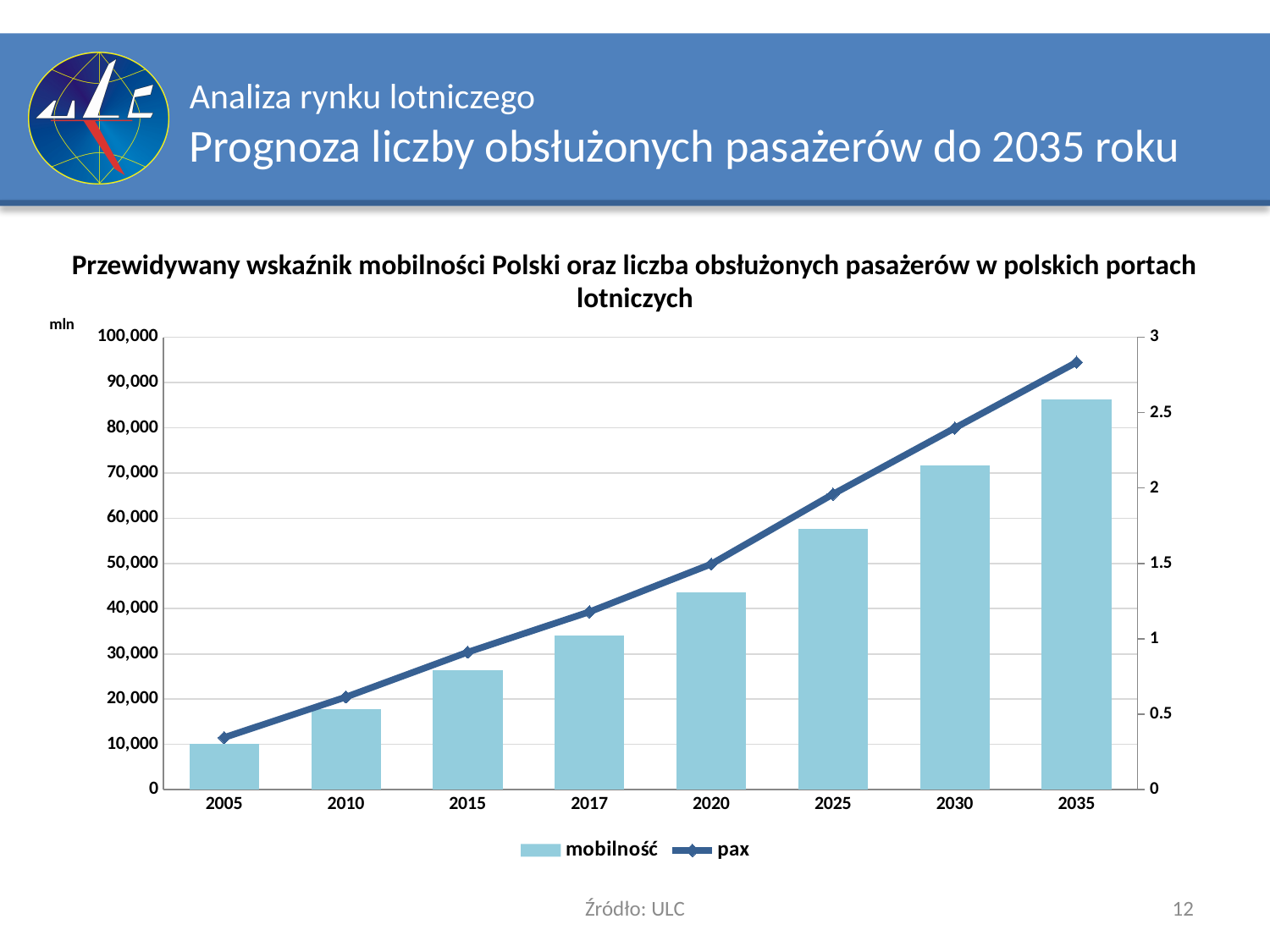
Which year has the tallest bar in the chart? 2035 Is the bar value for 2035 greater or less than 80,000? greater On the right axis, is the line value for 2035 greater or less than 2.5? greater How many series does the chart legend list? 2 What kind of chart is shown on the slide? A combined bar and line chart Is the bar value for 2025 greater or less than 50,000? greater How many years are shown on the x axis of the chart? 8 Which year has the shortest bar in the chart? 2005 Do the bar values rise or fall from 2005 to 2035? rise